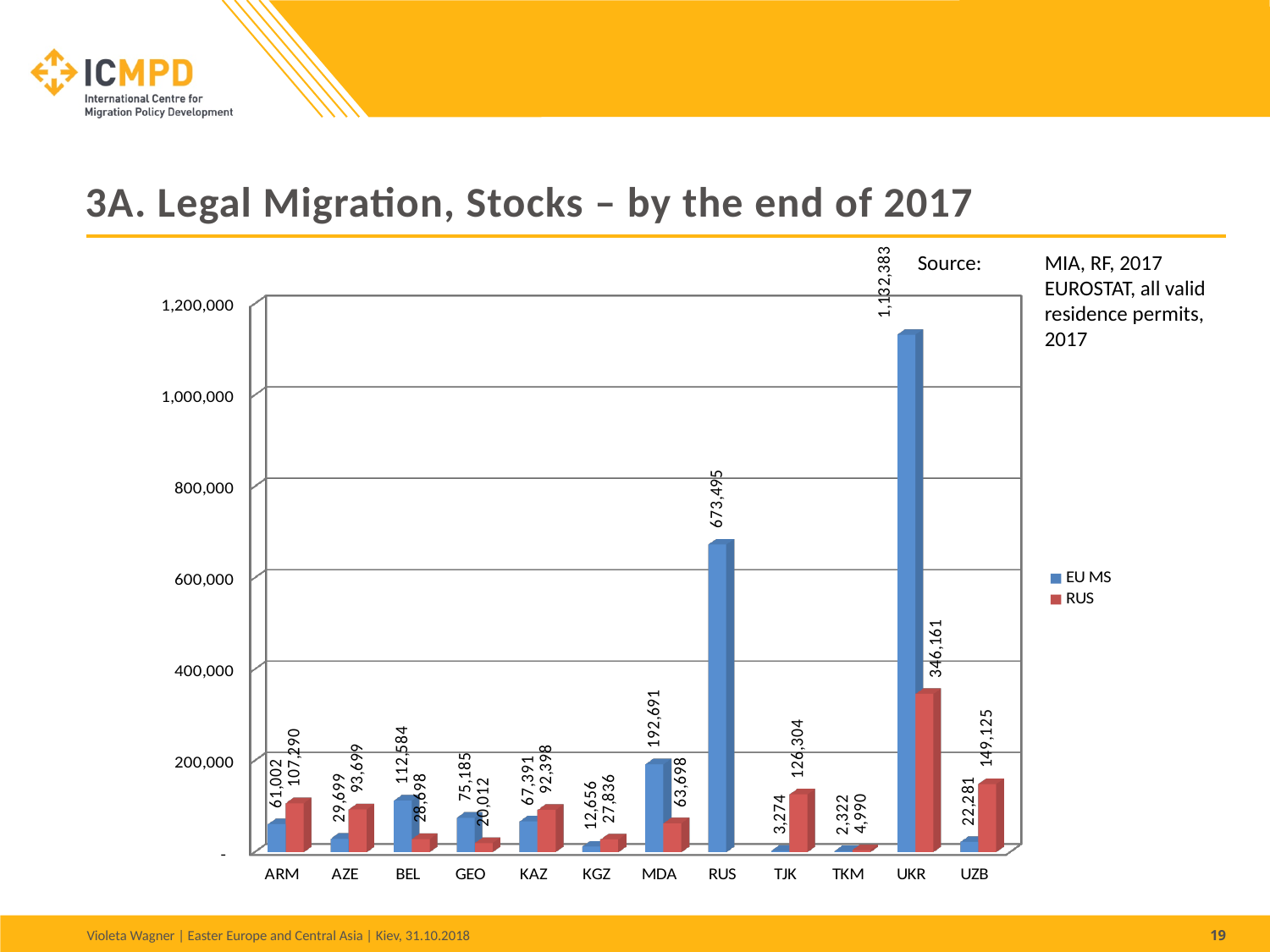
What is the EU MS value for UKR? 1,132,383 What is the RUS value for UZB? 149,125 What is the EU MS value for MDA? 192,691 Which country has the lowest EU MS value? TKM Which country has the highest EU MS value? UKR What is the difference between the RUS value and the EU MS value for UKR? 786,222 What type of chart is shown on the slide? Bar chart How many countries are shown on the x axis? 12 Is the EU MS value for RUS greater or less than 600,000? greater What is the RUS value for TJK? 126,304 For ARM, which is larger: the EU MS value or the RUS value? RUS How many series does the legend list? 2